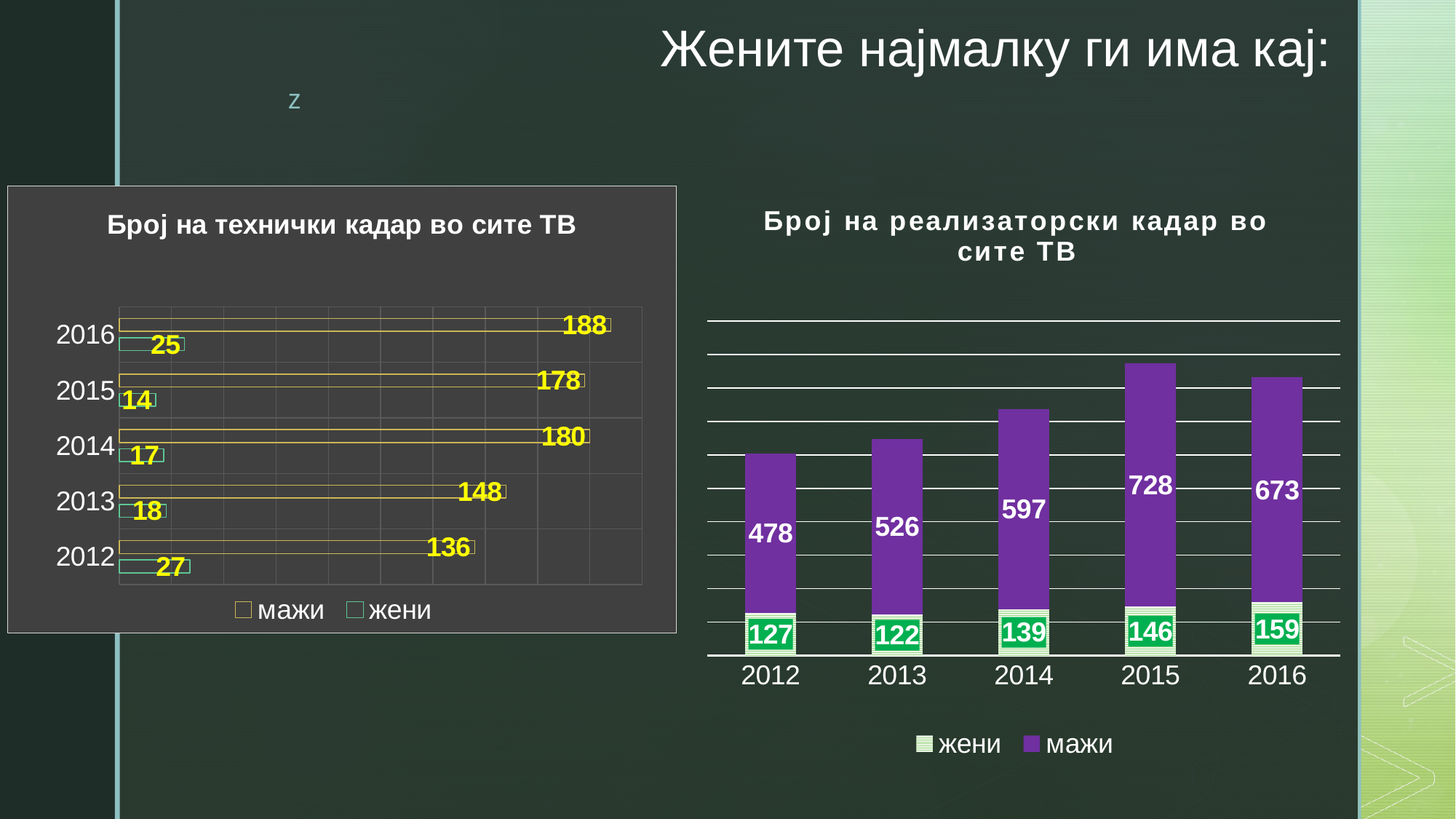
In the chart titled "Број на реализаторски кадар во сите ТВ", what is the total of the stacked bar for 2013? 648 In the chart titled "Број на технички кадар во сите ТВ", what is the difference between мажи and жени in 2012? 109 In the chart titled "Број на технички кадар во сите ТВ", what kind of chart is shown? bar chart In the chart titled "Број на реализаторски кадар во сите ТВ", how many years are shown on the x axis? 5 In the chart titled "Број на реализаторски кадар во сите ТВ", which year has the highest value for мажи? 2015 In the chart titled "Број на реализаторски кадар во сите ТВ", which is larger: жени in 2012 or жени in 2015? жени in 2015 In the chart titled "Број на реализаторски кадар во сите ТВ", what is the value for жени in 2016? 159 In the chart titled "Број на технички кадар во сите ТВ", how many series does the legend list? 2 In the chart titled "Број на технички кадар во сите ТВ", what is the value for мажи in 2016? 188 In the chart titled "Број на реализаторски кадар во сите ТВ", what is the value for мажи in 2014? 597 In the chart titled "Број на технички кадар во сите ТВ", what is the value for жени in 2015? 14 In the chart titled "Број на технички кадар во сите ТВ", which year has the lowest value for жени? 2015